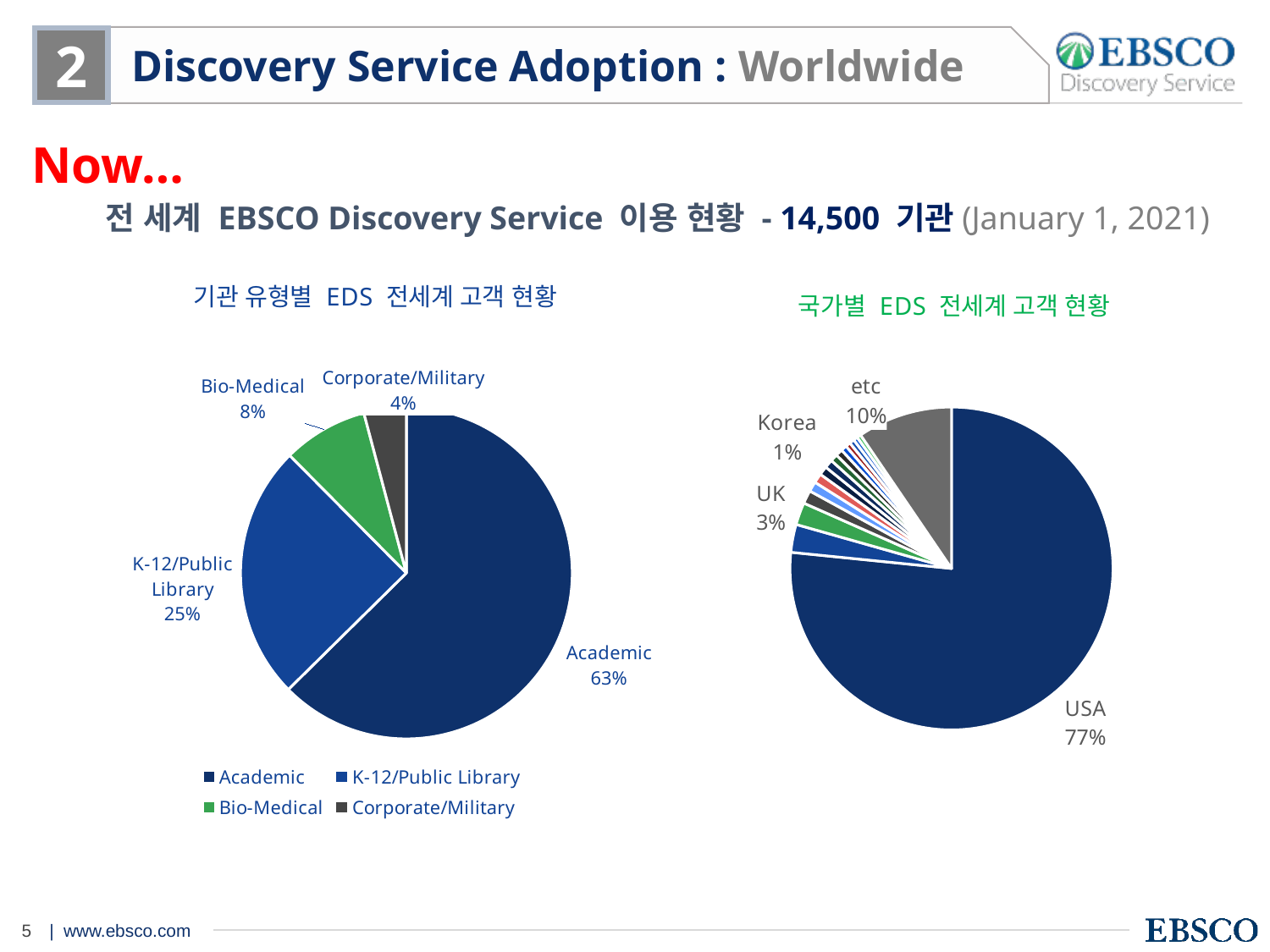
In the left pie chart (기관 유형별 EDS 전세계 고객 현황), which is larger, Bio-Medical or Corporate/Military? Bio-Medical In the right pie chart (국가별 EDS 전세계 고객 현황), what share does USA hold? 77% What type of chart is used for 국가별 EDS 전세계 고객 현황 on the right? Pie chart In the right pie chart (국가별 EDS 전세계 고객 현황), what is the difference between the UK and Korea shares? 2% In the left pie chart (기관 유형별 EDS 전세계 고객 현황), what is the value for K-12/Public Library? 25% In the left pie chart (기관 유형별 EDS 전세계 고객 현황), which category has the largest slice? Academic In the left pie chart (기관 유형별 EDS 전세계 고객 현황), what share does Academic hold? 63% In the left pie chart (기관 유형별 EDS 전세계 고객 현황), what is the difference between the Academic and K-12/Public Library shares? 38% In the right pie chart (국가별 EDS 전세계 고객 현황), what is the value for Korea? 1% In the left pie chart (기관 유형별 EDS 전세계 고객 현황), which category has the smallest slice? Corporate/Military How many entries does the legend of the left pie chart (기관 유형별 EDS 전세계 고객 현황) list? 4 In the left pie chart (기관 유형별 EDS 전세계 고객 현황), how many categories are shown? 4